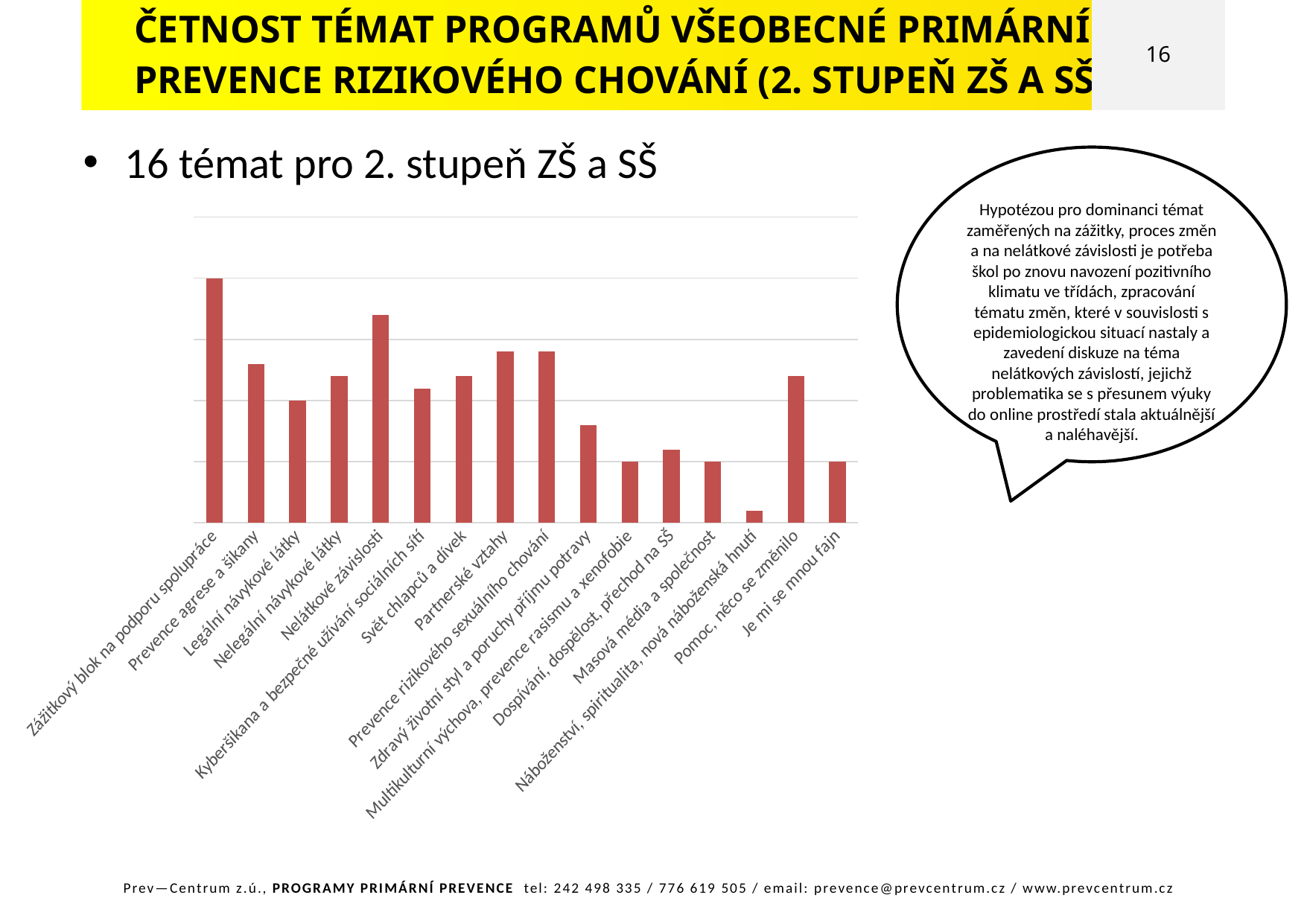
Which has the higher bar: Masová média a společnost or Náboženství, spiritualita, nová náboženská hnutí? Masová média a společnost Which has the higher bar: Zdravý životní styl a poruchy příjmu potravy or Dospívání, dospělost, přechod na SŠ? Zdravý životní styl a poruchy příjmu potravy How many categories (topics) are plotted in the chart? 16 Which has the higher bar: Pomoc, něco se změnilo or Je mi se mnou fajn? Pomoc, něco se změnilo What is the label of the first (leftmost) category in the chart? Zážitkový blok na podporu spolupráce Which topic has the highest bar in the chart? Zážitkový blok na podporu spolupráce Which topic has the lowest bar in the chart? Náboženství, spiritualita, nová náboženská hnutí What kind of chart is shown on the slide? bar chart What colour are the bars in the chart? red